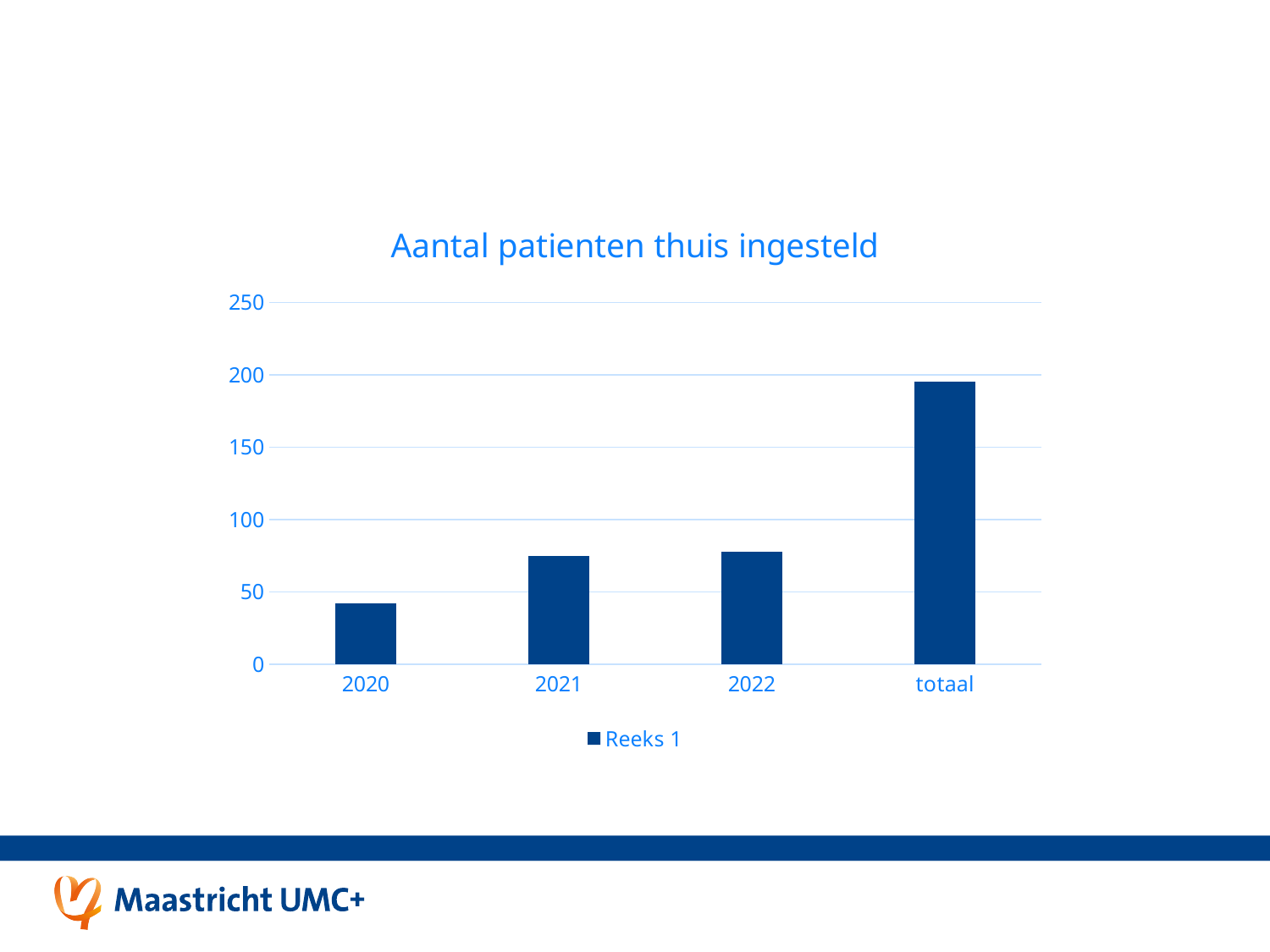
Is the value for 2022 greater or less than 100? less Is the value for 2020 greater or less than 50? less What is the title of the chart? Aantal patienten thuis ingesteld What is the name of the series shown in the legend? Reeks 1 Which is larger, the value for 2020 or the value for 2021? 2021 What kind of chart is shown on the slide? Bar chart How many categories are shown on the x axis of the chart? 4 Is the value for totaal greater or less than 150? greater How many series does the legend list? 1 Which category has the highest bar? totaal Which category has the lowest bar? 2020